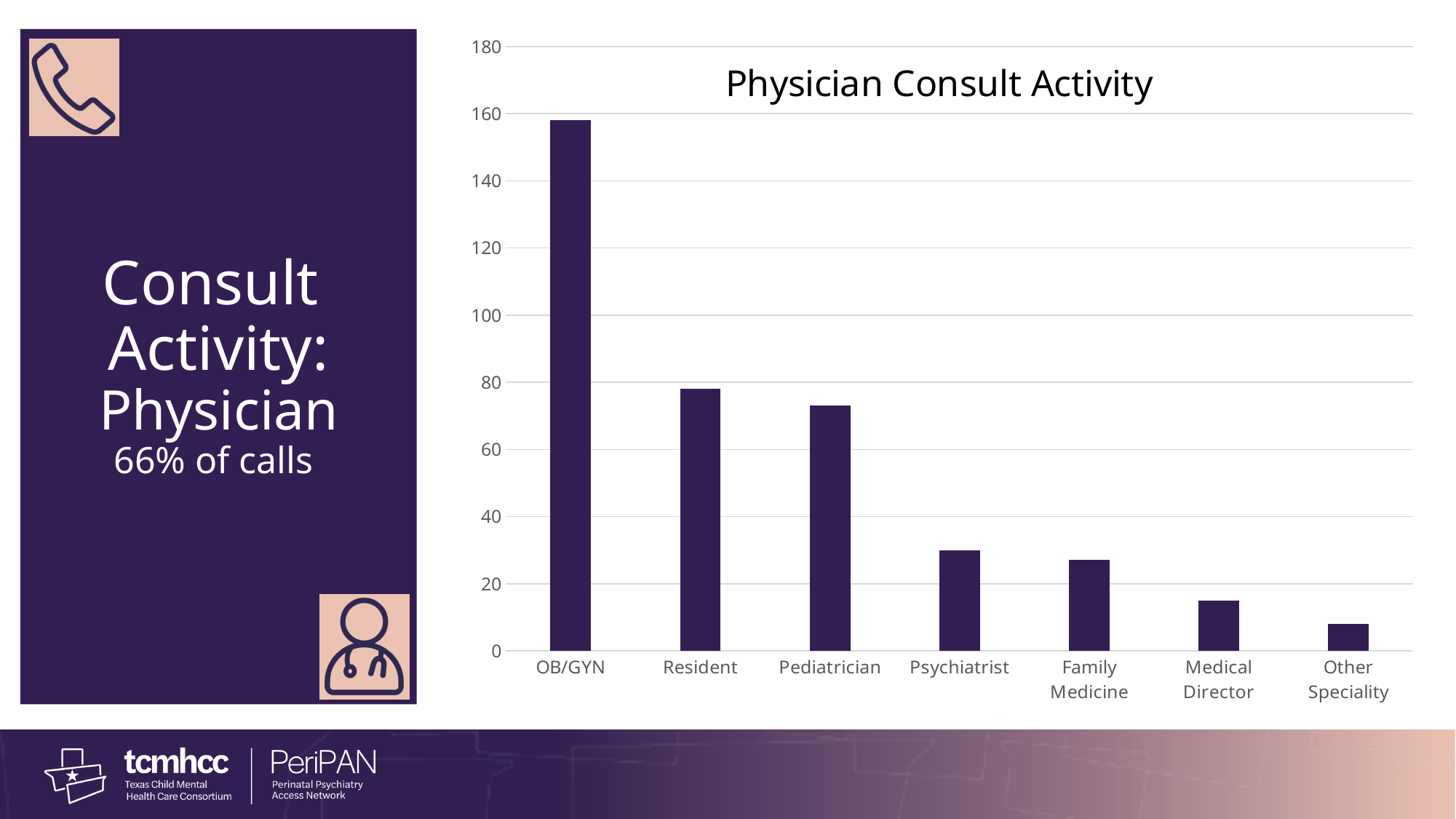
Which category has the highest value in the chart? OB/GYN Which category has the lowest value in the chart? Other Speciality What type of chart is shown on the slide? bar chart Which has a larger value, OB/GYN or Resident? OB/GYN Is the value for Pediatrician greater or less than 80? less Do the values rise or fall moving from left to right along the x axis? fall How many categories are shown on the x axis of the chart? 7 Is the value for Resident greater or less than 60? greater Is the value for Medical Director greater or less than 20? less What is the title of the chart? Physician Consult Activity